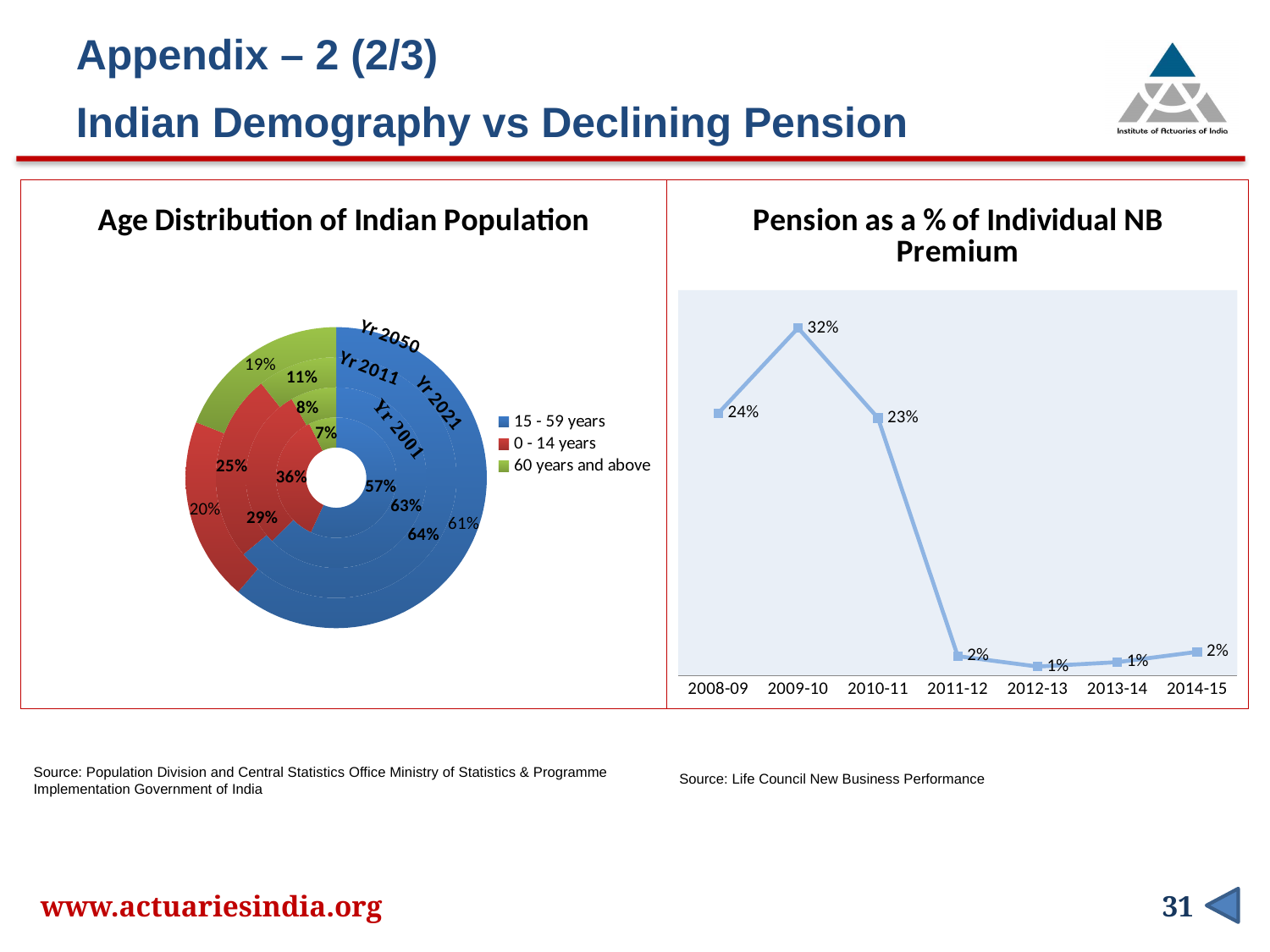
How many years are plotted in the 'Pension as a % of Individual NB Premium' chart? 7 In the 'Age Distribution of Indian Population' chart, what is the value for '60 years and above' in the outermost ring? 19% In the 'Pension as a % of Individual NB Premium' chart, what is the difference between the values for 2009-10 and 2010-11? 9% In the 'Pension as a % of Individual NB Premium' chart, do the values overall rise or fall from 2008-09 to 2014-15? Fall In the 'Pension as a % of Individual NB Premium' chart, what is the value for 2008-09? 24% In the 'Pension as a % of Individual NB Premium' chart, what is the value for 2014-15? 2% How many series does the legend of the 'Age Distribution of Indian Population' chart list? 3 What kind of chart is the 'Age Distribution of Indian Population' chart? Doughnut chart In the 'Pension as a % of Individual NB Premium' chart, which is larger: the value for 2008-09 or the value for 2010-11? 2008-09 What kind of chart is the 'Pension as a % of Individual NB Premium' chart? Line chart In the 'Pension as a % of Individual NB Premium' chart, what is the value for 2009-10? 32% In the 'Pension as a % of Individual NB Premium' chart, which year has the highest value? 2009-10